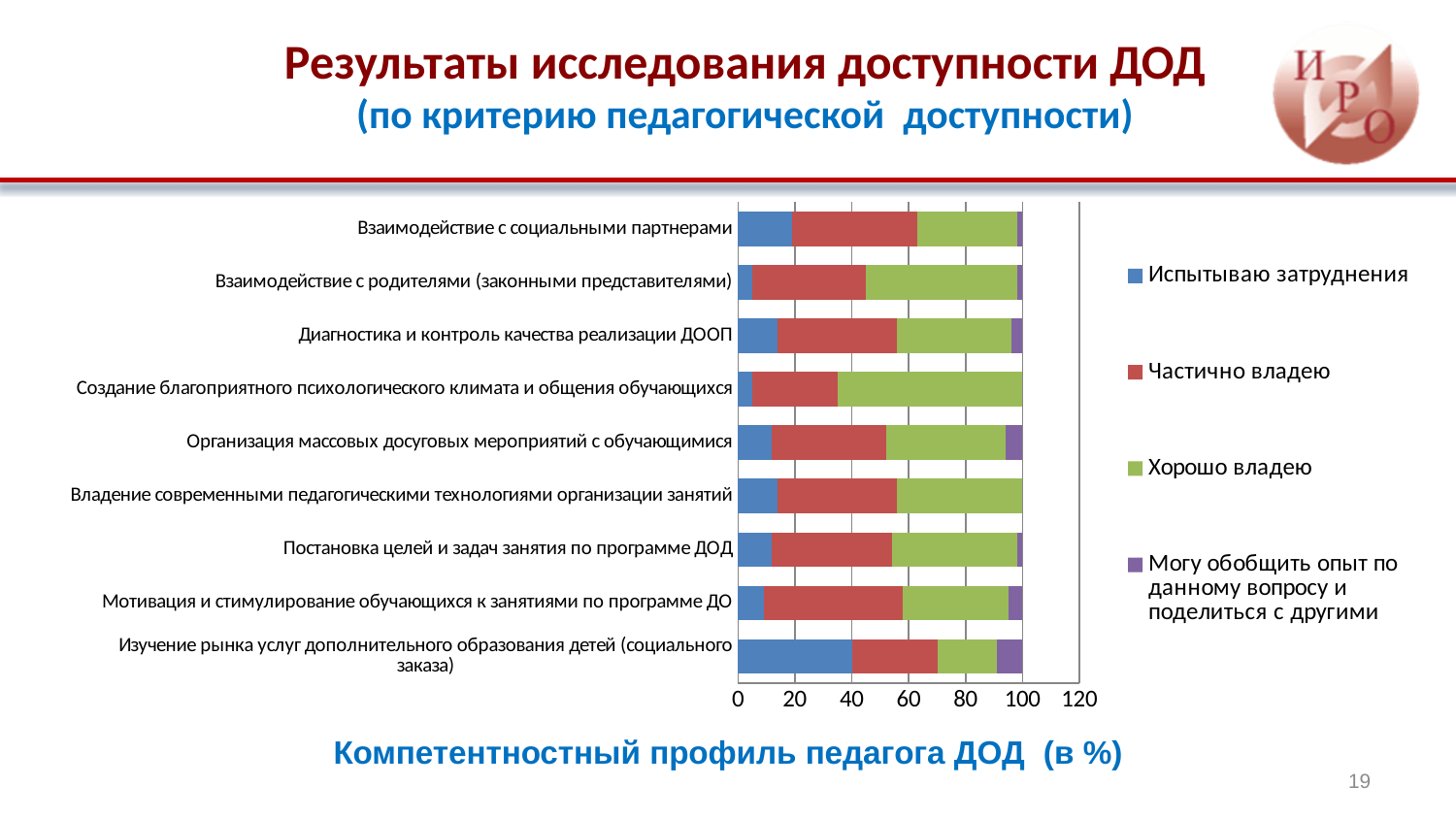
Is the "Испытываю затруднения" value for "Взаимодействие с родителями (законными представителями)" greater or less than 20? less Which category has the largest "Хорошо владею" segment? Создание благоприятного психологического климата и общения обучающихся What kind of chart is shown on the slide? Stacked bar chart Is the "Испытываю затруднения" value for "Изучение рынка услуг дополнительного образования детей (социального заказа)" greater or less than 20? greater What colour represents the "Хорошо владею" series in the legend? Green Which is larger: the "Испытываю затруднения" value for "Изучение рынка услуг дополнительного образования детей (социального заказа)" or for "Взаимодействие с родителями (законными представителями)"? Изучение рынка услуг дополнительного образования детей (социального заказа) What is the highest tick value shown on the horizontal axis? 120 How many categories (competency areas) are plotted on the chart? 9 Which is larger: the "Хорошо владею" value for "Создание благоприятного психологического климата и общения обучающихся" or for "Взаимодействие с социальными партнерами"? Создание благоприятного психологического климата и общения обучающихся Which category has the largest "Испытываю затруднения" segment? Изучение рынка услуг дополнительного образования детей (социального заказа) How many series does the legend list? 4 Is the "Хорошо владею" value for "Создание благоприятного психологического климата и общения обучающихся" greater or less than 40? greater